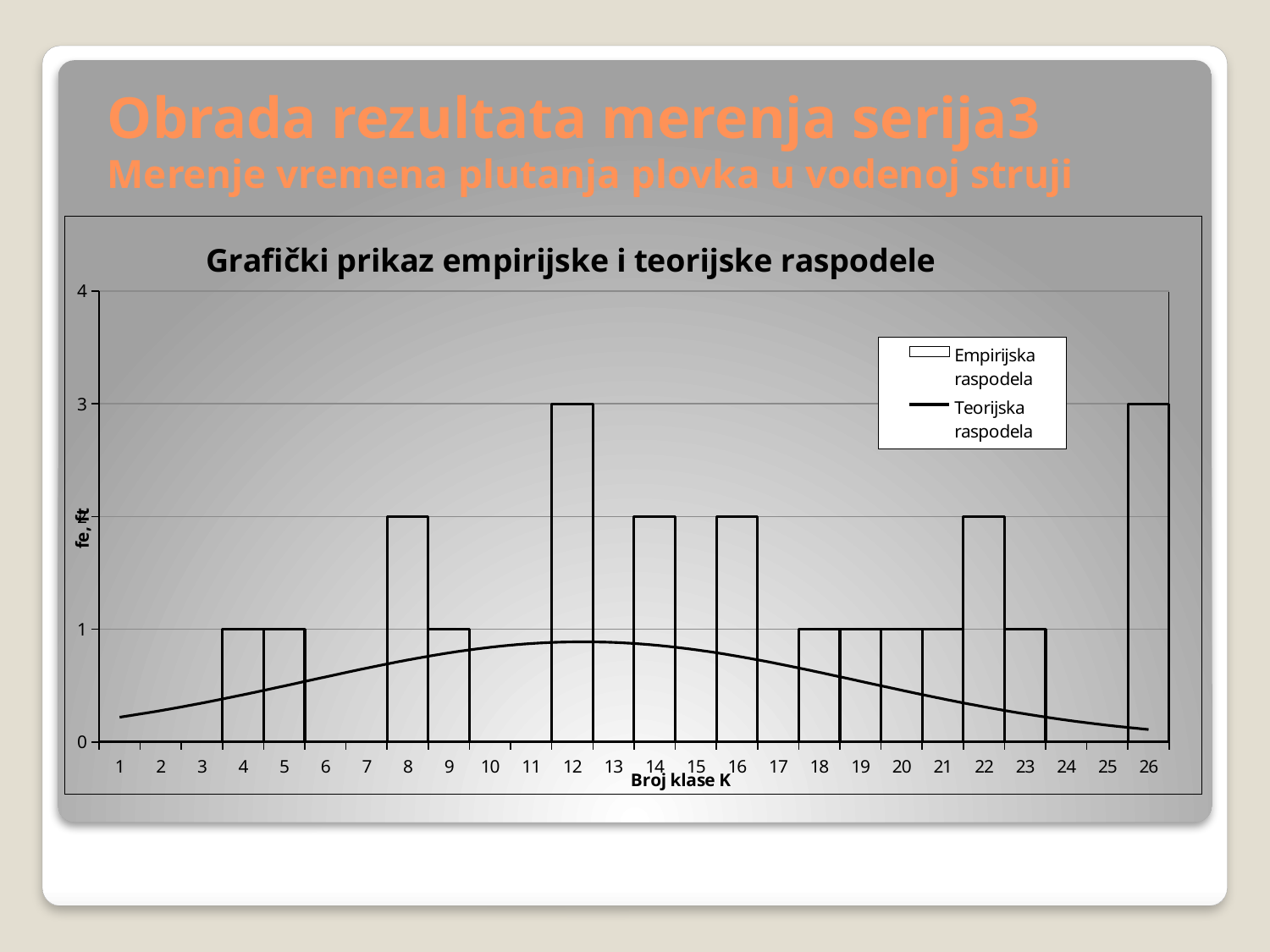
What is the title of the chart? Grafički prikaz empirijske i teorijske raspodele What is the value of the Empirijska raspodela bar for class 8? 2 What is the label of the x axis? Broj klase K Which has a larger Empirijska raspodela value, class 22 or class 23? class 22 What is the value of the Empirijska raspodela bar for class 19? 1 What is the value of the Empirijska raspodela bar for class 12? 3 Is the Teorijska raspodela value at class 12 greater or less than 1? less How many classes (Broj klase K) are shown on the x axis? 26 What is the difference between the Empirijska raspodela values for class 12 and class 14? 1 Does the Teorijska raspodela line rise or fall from class 13 to class 26? fall How many series does the chart legend list? 2 What is the value of the Empirijska raspodela bar for class 26? 3